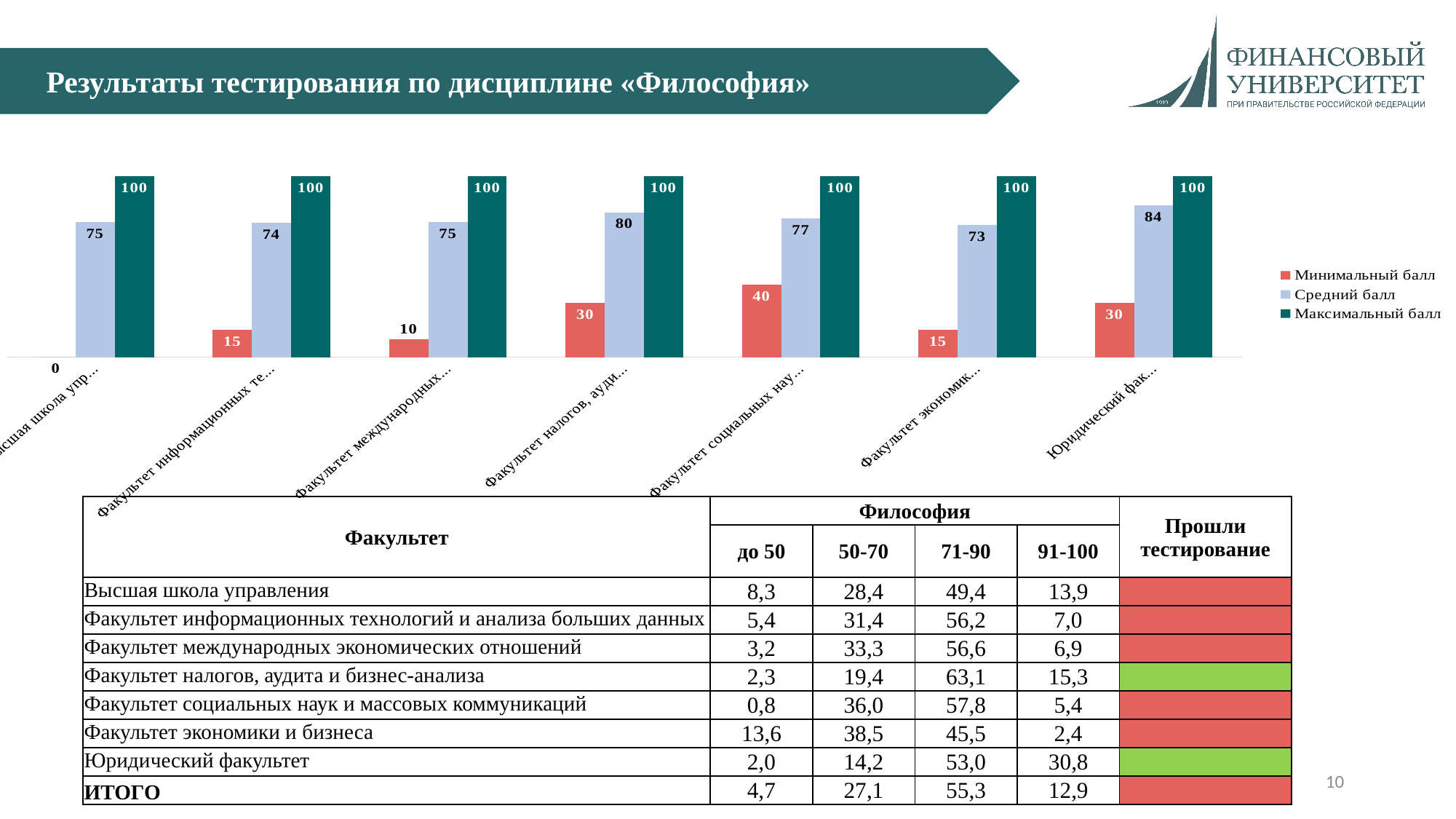
How many faculties (categories) are shown on the chart? 7 Which faculty has the highest Средний балл (average score)? Юридический факультет Which has the larger Минимальный балл: Факультет налогов, аудита и бизнес-анализа or Факультет социальных наук и массовых коммуникаций? Факультет социальных наук и массовых коммуникаций Which faculty has the lowest Средний балл (average score)? Факультет экономики и бизнеса What is the Средний балл (average score) for Юридический факультет? 84 What type of chart is shown on the slide? Bar chart What is the Максимальный балл (maximum score) for Факультет налогов, аудита и бизнес-анализа? 100 Which faculty has the lowest Минимальный балл (minimum score)? Высшая школа управления What is the difference between the Средний балл of Юридический факультет and that of Факультет экономики и бизнеса? 11 How many series does the chart legend list? 3 Which series is shown in red in the chart legend? Минимальный балл What is the Минимальный балл (minimum score) for Факультет социальных наук и массовых коммуникаций? 40